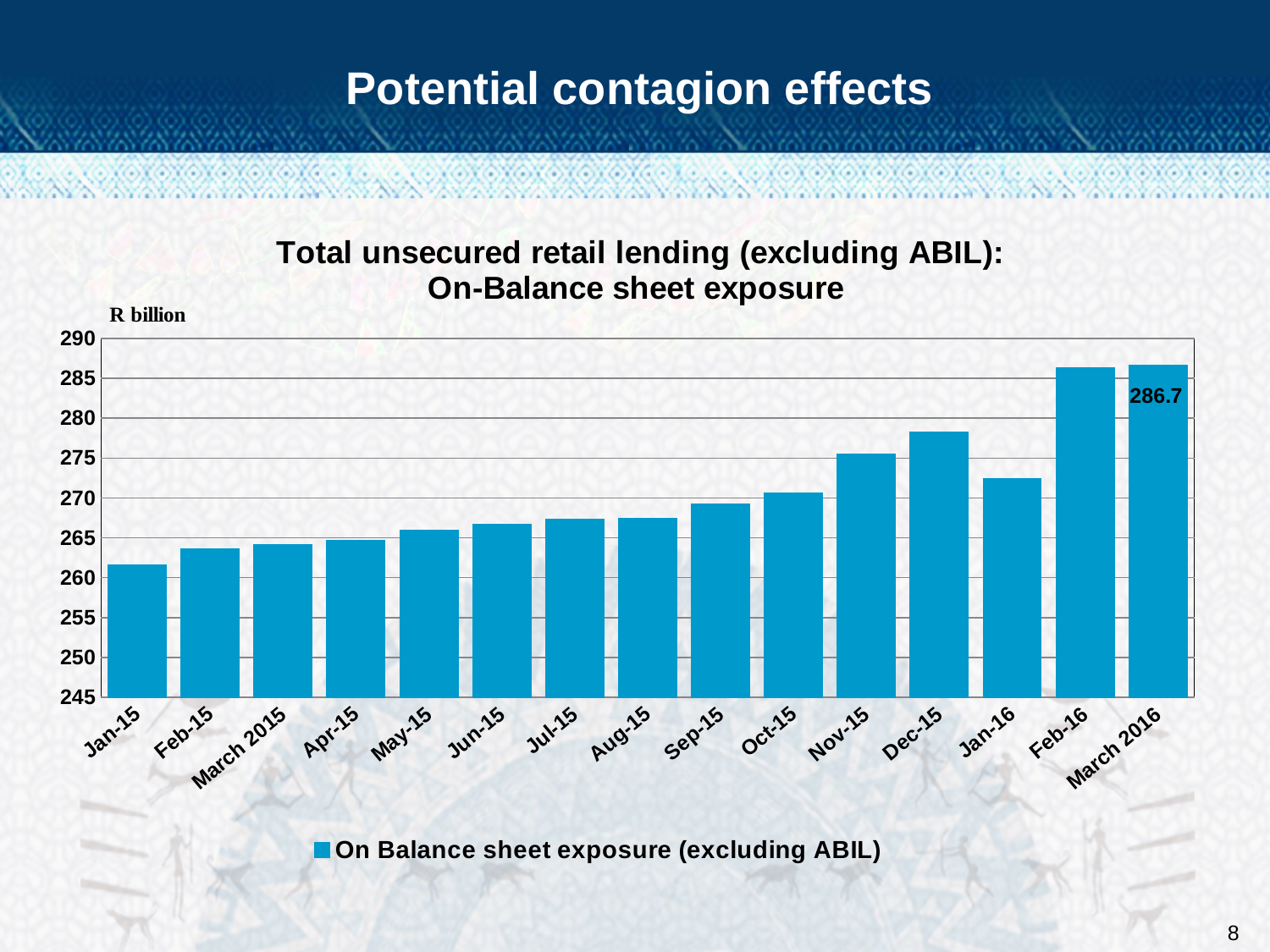
What is the value for March 2016? 286.7 How many series does the legend list? 1 Is the value for Jan-15 greater or less than 260? greater How many months are plotted on the chart? 15 Is the value for Dec-15 greater or less than 275? greater Do the values generally rise or fall from Jan-15 to March 2016? Rise Is the value for Jan-16 greater or less than 275? less Which is larger, the value for Dec-15 or the value for Jan-16? Dec-15 What kind of chart is shown on the slide? Bar chart Which month has the lowest on-balance sheet exposure? Jan-15 What unit is shown on the vertical axis of the chart? R billion